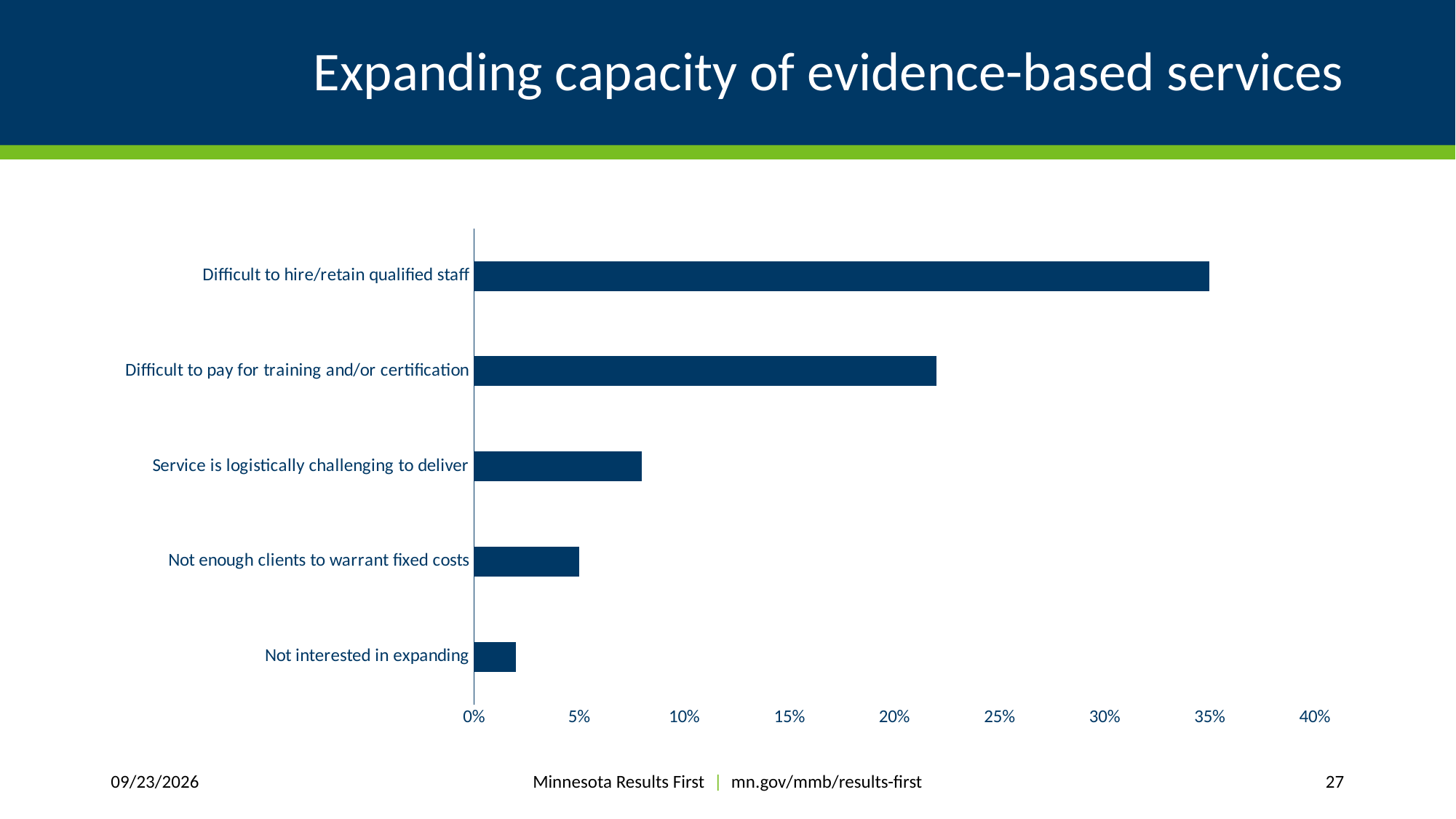
Is the value for "Service is logistically challenging to deliver" greater or less than 10%? less Is the value for "Not interested in expanding" greater or less than 5%? less How many categories are plotted in the chart? 5 What is the title of the slide containing the chart? Expanding capacity of evidence-based services What is the maximum value shown on the horizontal axis? 40% What is the value for "Not enough clients to warrant fixed costs"? 5% What kind of chart is shown on the slide? bar chart Which is larger: the value for "Difficult to pay for training and/or certification" or the value for "Service is logistically challenging to deliver"? Difficult to pay for training and/or certification Which category has the lowest value? Not interested in expanding Is the value for "Difficult to pay for training and/or certification" greater or less than 20%? greater What is the value for "Difficult to hire/retain qualified staff"? 35% Which category has the highest value? Difficult to hire/retain qualified staff